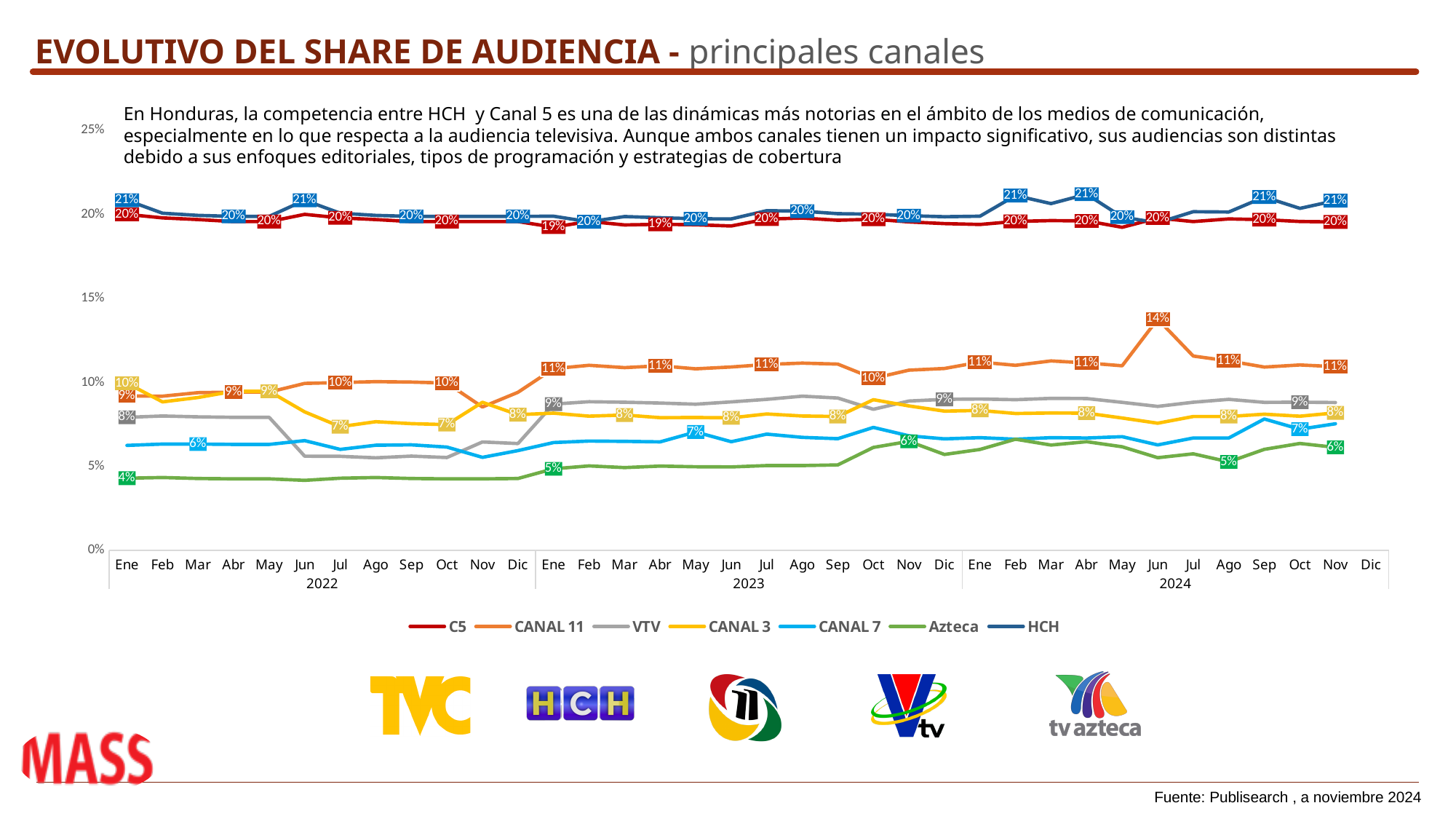
In Ene 2022, which had the larger share, CANAL 11 or CANAL 3? CANAL 3 What was the share for CANAL 11 in Jun 2024? 14% Which channel had the lowest share in Ene 2022? Azteca What was the share for Azteca in Ene 2022? 4% Does the Azteca share rise or fall from Ene 2022 to Nov 2024? rise What kind of chart is shown on the slide? line chart What is the difference between the HCH and C5 shares in Nov 2024? 1% How many series does the legend list? 7 What was the share for HCH in Ene 2022? 21% Is the value for Azteca in Jun 2022 greater or less than 5%? less What was the share for CANAL 7 in Mar 2022? 6% Which channel had the highest share in Nov 2024? HCH